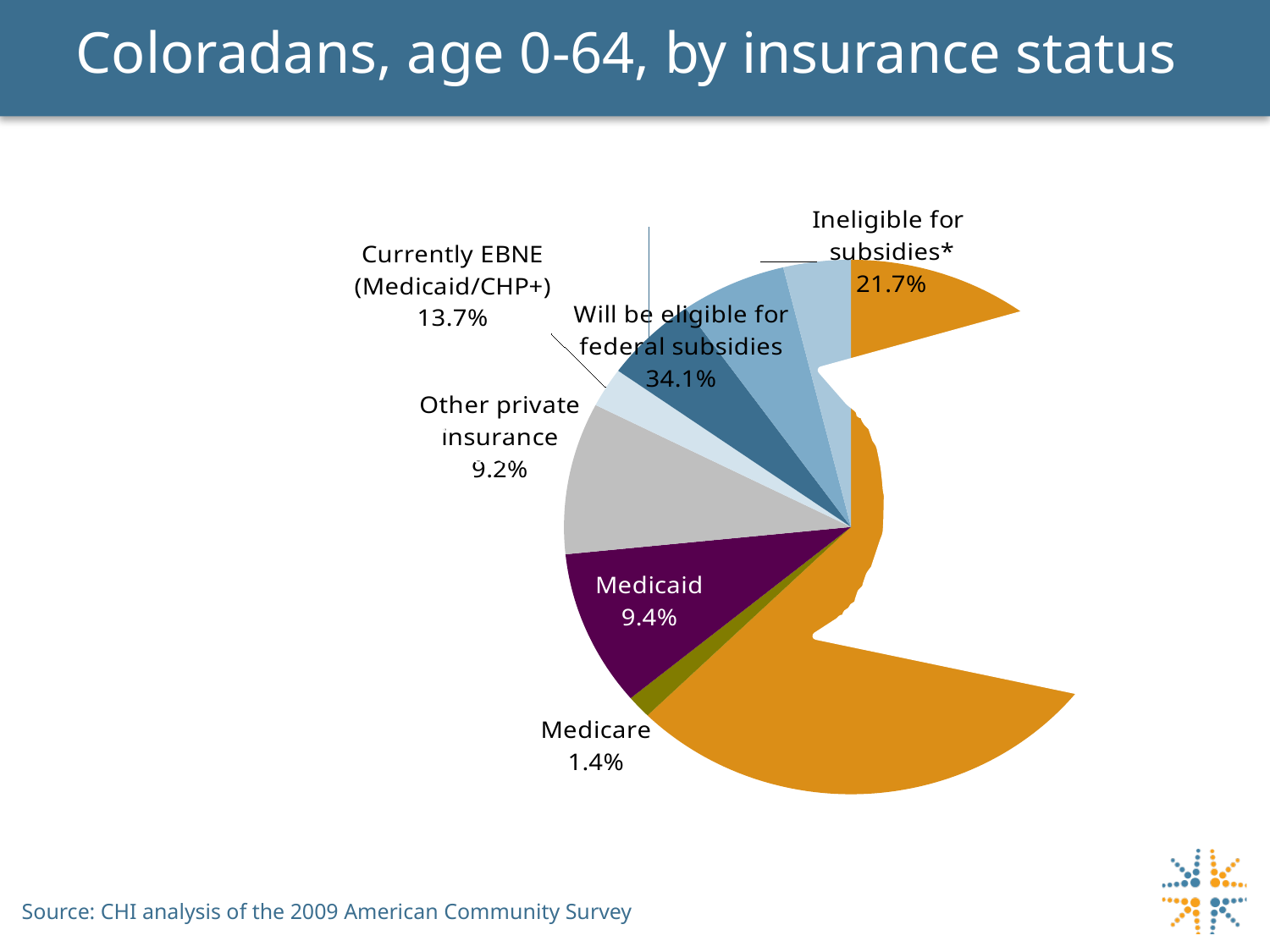
What percentage is shown for Medicare? 1.4% What percentage is shown for Ineligible for subsidies*? 21.7% Which labeled category has the smallest share? Medicare What percentage is shown for Medicaid? 9.4% What percentage is shown for Other private insurance? 9.2% What is the difference in percentage points between Currently EBNE (Medicaid/CHP+) (13.7%) and Medicaid (9.4%)? 4.3 What is the difference in percentage points between Will be eligible for federal subsidies (34.1%) and Ineligible for subsidies* (21.7%)? 12.4 What kind of chart is shown on the slide? pie chart Which is larger: Will be eligible for federal subsidies or Ineligible for subsidies*? Will be eligible for federal subsidies What percentage is shown for Currently EBNE (Medicaid/CHP+)? 13.7% What percentage of Coloradans age 0-64 will be eligible for federal subsidies? 34.1% What is the title of the chart? Coloradans, age 0-64, by insurance status